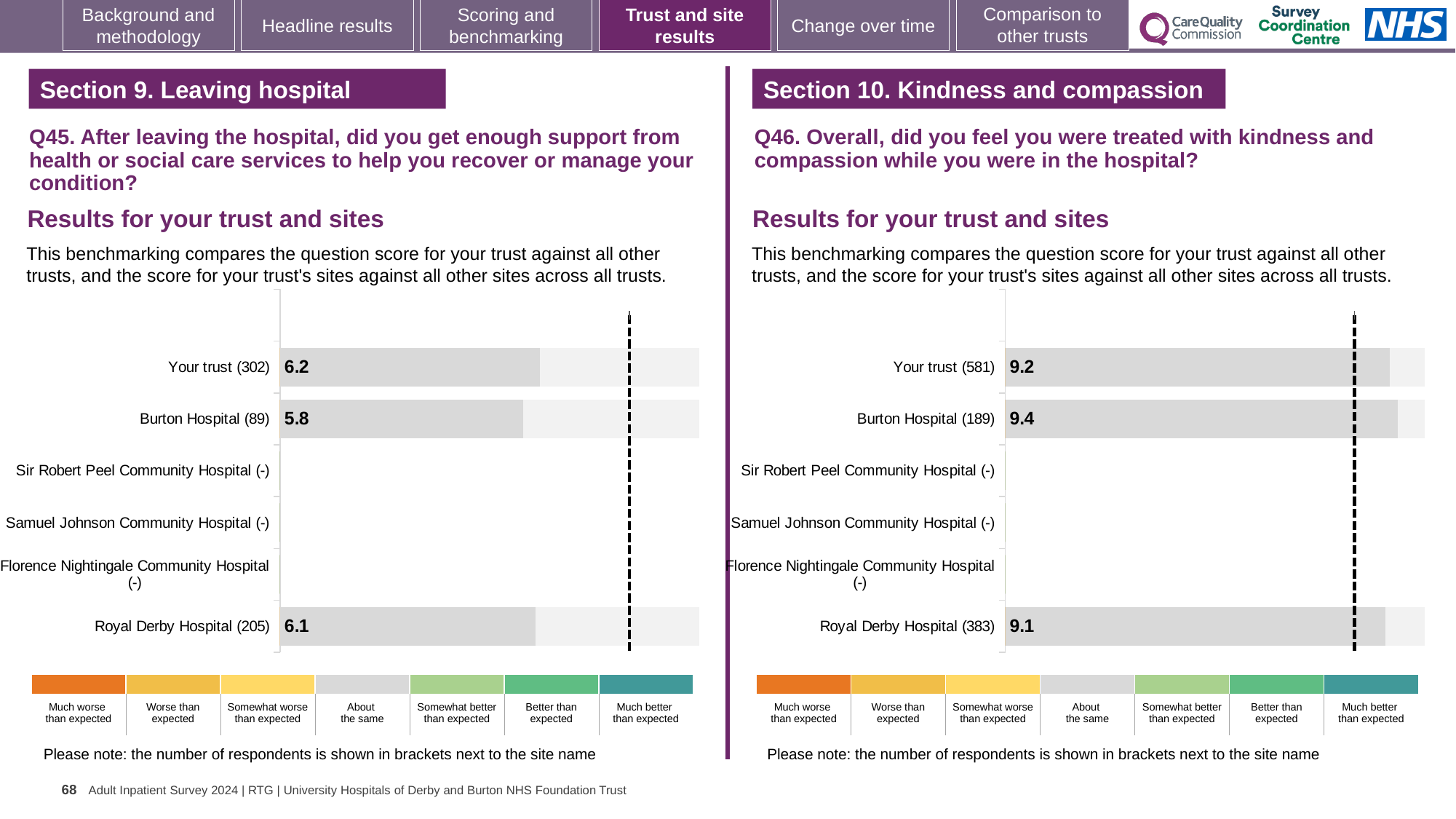
On the Q46 chart (right), which of the plotted sites or trust has the highest score? Burton Hospital (189) What kind of chart is used on the Q45 chart (left)? Bar chart On the Q45 chart (left), what is the difference between the score for Your trust (302) and Burton Hospital (89)? 0.4 How many site or trust labels are listed on the Q46 chart (right)? 6 On the Q45 chart (left), what is the score for Your trust (302)? 6.2 On the Q46 chart (right), what is the difference between the score for Burton Hospital (189) and Royal Derby Hospital (383)? 0.3 On the Q46 chart (right), what is the score for Royal Derby Hospital (383)? 9.1 On the Q45 chart (left), which of the plotted sites or trust has the lowest score? Burton Hospital (89) On the Q45 chart (left), which has the larger score: Your trust (302) or Royal Derby Hospital (205)? Your trust (302) On the Q45 chart (left), what is the score for Burton Hospital (89)? 5.8 On the Q46 chart (right), what is the score for Burton Hospital (189)? 9.4 On the Q45 chart (left), how many sites are shown with (-) and no plotted bar? 3